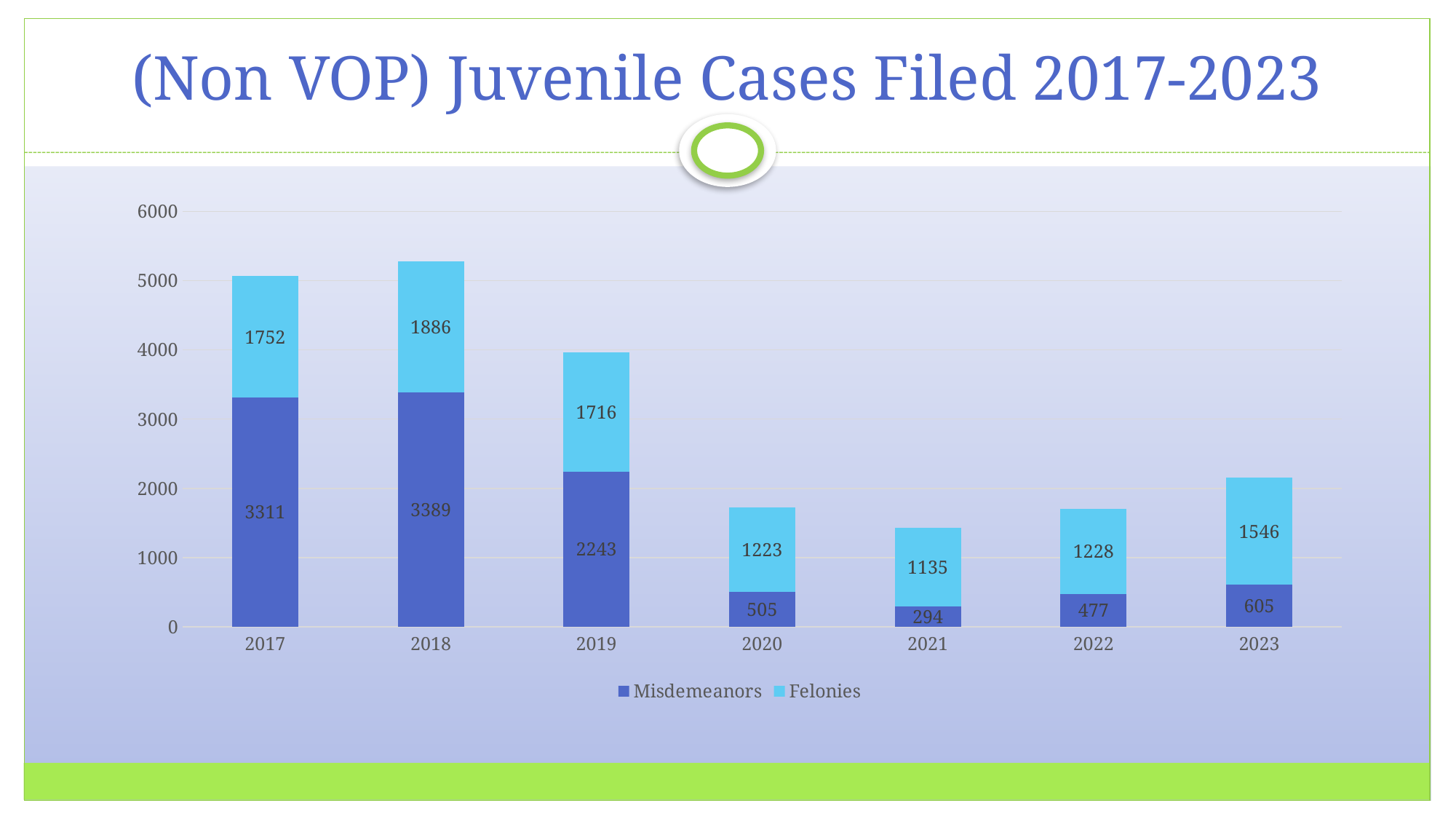
What kind of chart is shown on the slide? Stacked bar chart What is the number of Felonies in 2023? 1546 Which year has the lowest number of Felonies? 2021 What is the total number of cases filed in 2019 (Misdemeanors plus Felonies)? 3959 How many years are shown on the x axis? 7 How many series does the legend list? 2 Which is larger: Misdemeanors in 2020 or Misdemeanors in 2023? Misdemeanors in 2023 Is the total height of the 2018 bar greater or less than 5000? greater Which year has the highest number of Misdemeanors? 2018 What is the difference between Felonies in 2018 and Felonies in 2017? 134 What is the number of Misdemeanors in 2021? 294 What is the number of Misdemeanors in 2017? 3311